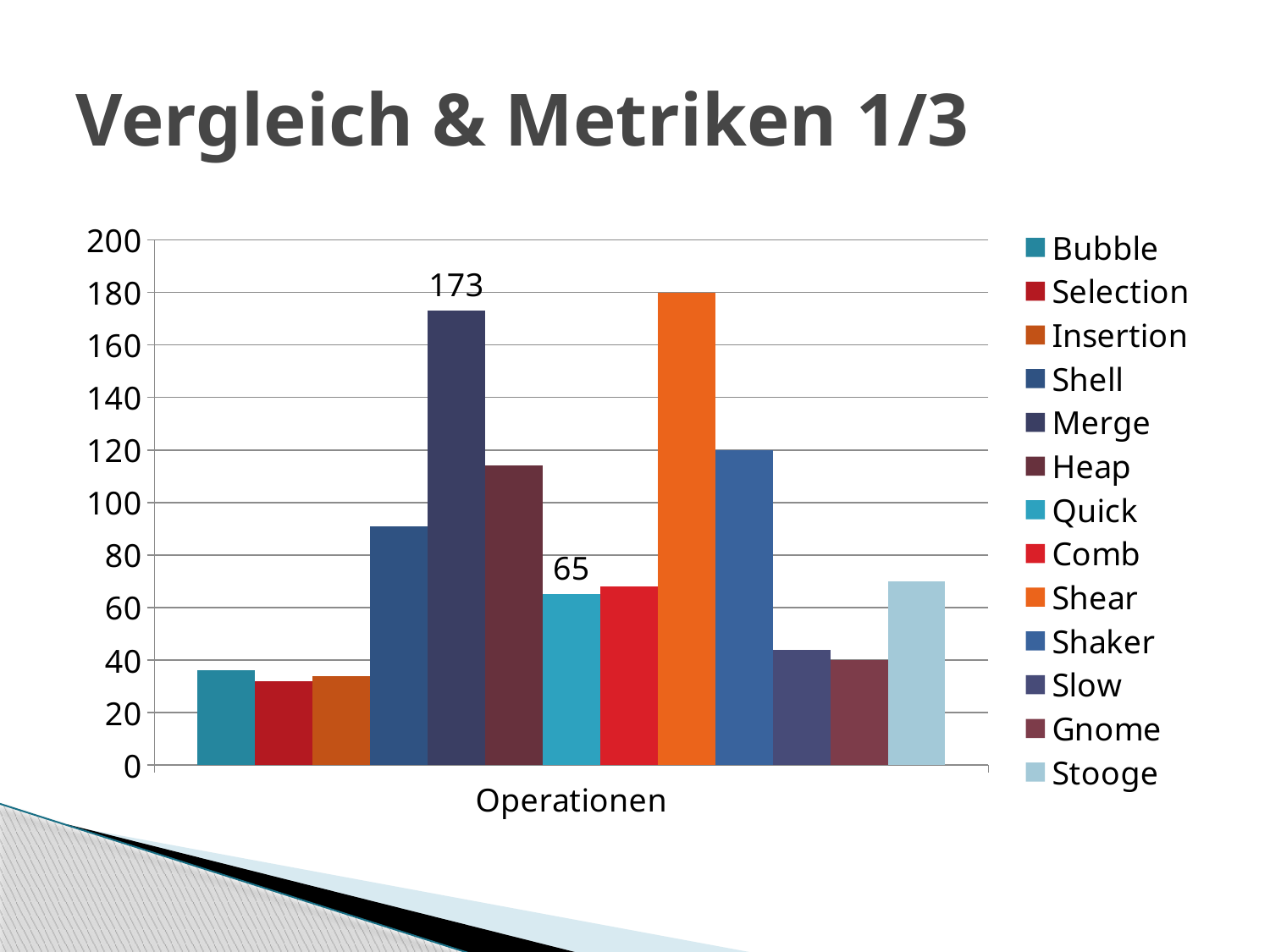
Is the value for Heap greater or less than 100? greater What is the value for Quick? 65 Which is larger, the value for Bubble or the value for Stooge? Stooge Which series has the highest value? Shear How many series does the legend list? 13 What is the difference between the values for Merge and Quick? 108 Is the value for Bubble greater or less than 40? less What is the value for Merge? 173 Which is larger, the value for Merge or the value for Heap? Merge What is the label on the x axis of the chart? Operationen Is the value for Shell greater or less than 80? greater What type of chart is shown on the slide? bar chart